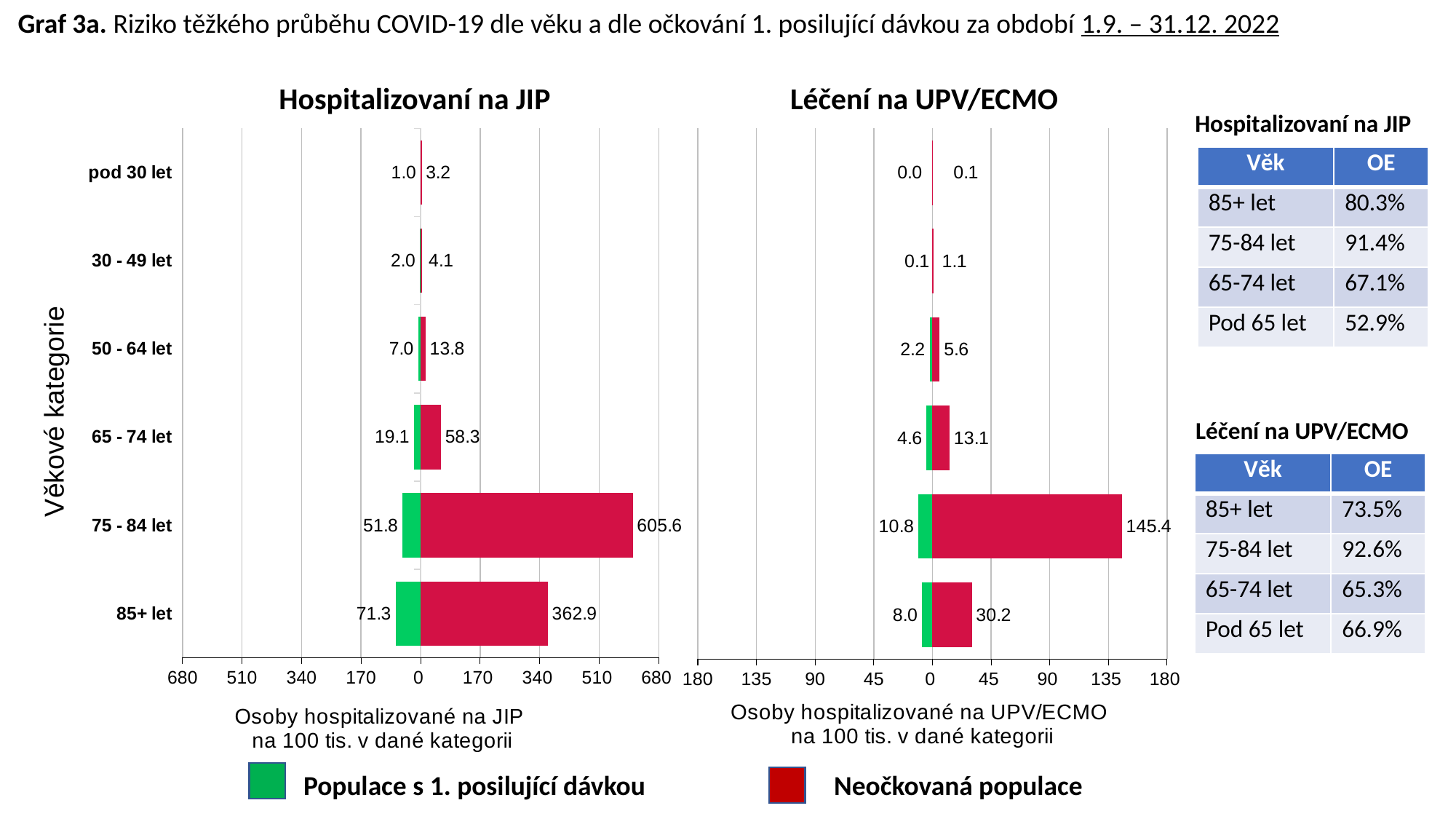
In the 'Hospitalizovaní na JIP' chart, what is the value for the unvaccinated population (Neočkovaná populace) in the 75 - 84 let category? 605.6 In the 'Léčení na UPV/ECMO' chart, what is the value for the unvaccinated population in the 75 - 84 let category? 145.4 In the 'Léčení na UPV/ECMO' chart, which age category has the lowest value for the population with the 1st booster dose? pod 30 let In the 'Hospitalizovaní na JIP' chart, what is the difference between the unvaccinated and boosted values in the 65 - 74 let category? 39.2 In the 'Hospitalizovaní na JIP' chart, which age category has the highest value for the unvaccinated population? 75 - 84 let How many series does the legend list? 2 In the 'Léčení na UPV/ECMO' chart, what is the value for the population with the 1st booster dose in the 50 - 64 let category? 2.2 In the 'Hospitalizovaní na JIP' chart, what is the value for the population with the 1st booster dose in the 85+ let category? 71.3 How many age categories are shown in the 'Hospitalizovaní na JIP' chart? 6 In the 'Hospitalizovaní na JIP' chart, is the unvaccinated value for 85+ let greater or less than 340? greater In the 'Léčení na UPV/ECMO' chart, which is larger in the 85+ let category: the unvaccinated value or the boosted value? Neočkovaná populace (30.2) What kind of chart is 'Léčení na UPV/ECMO'? bar chart